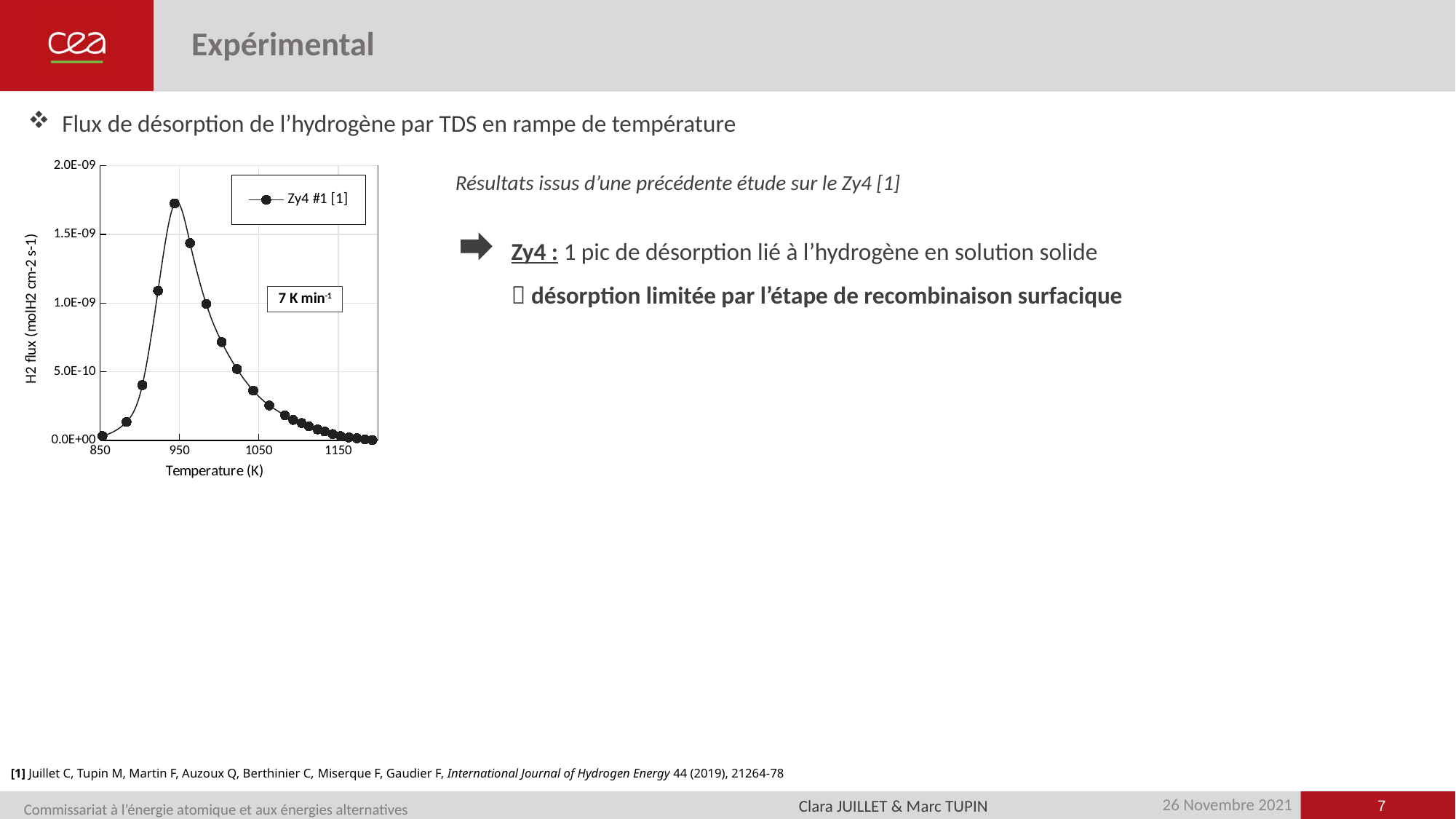
Is the H2 flux higher at 950 K or at 1150 K? 950 K Is the peak value of the Zy4 #1 [1] series greater or less than 1.5E-09? greater Do the values of the Zy4 #1 [1] series rise or fall between 950 K and 1150 K? fall What is the name of the series shown in the chart legend? Zy4 #1 [1] What is the label of the x axis of the chart? Temperature (K) How many series does the chart legend list? 1 Is the H2 flux at 1050 K greater or less than 1.0E-09? less Is the H2 flux at 1150 K greater or less than 5.0E-10? less What kind of chart is shown on the slide? line chart Do the values of the Zy4 #1 [1] series rise or fall between 850 K and 950 K? rise